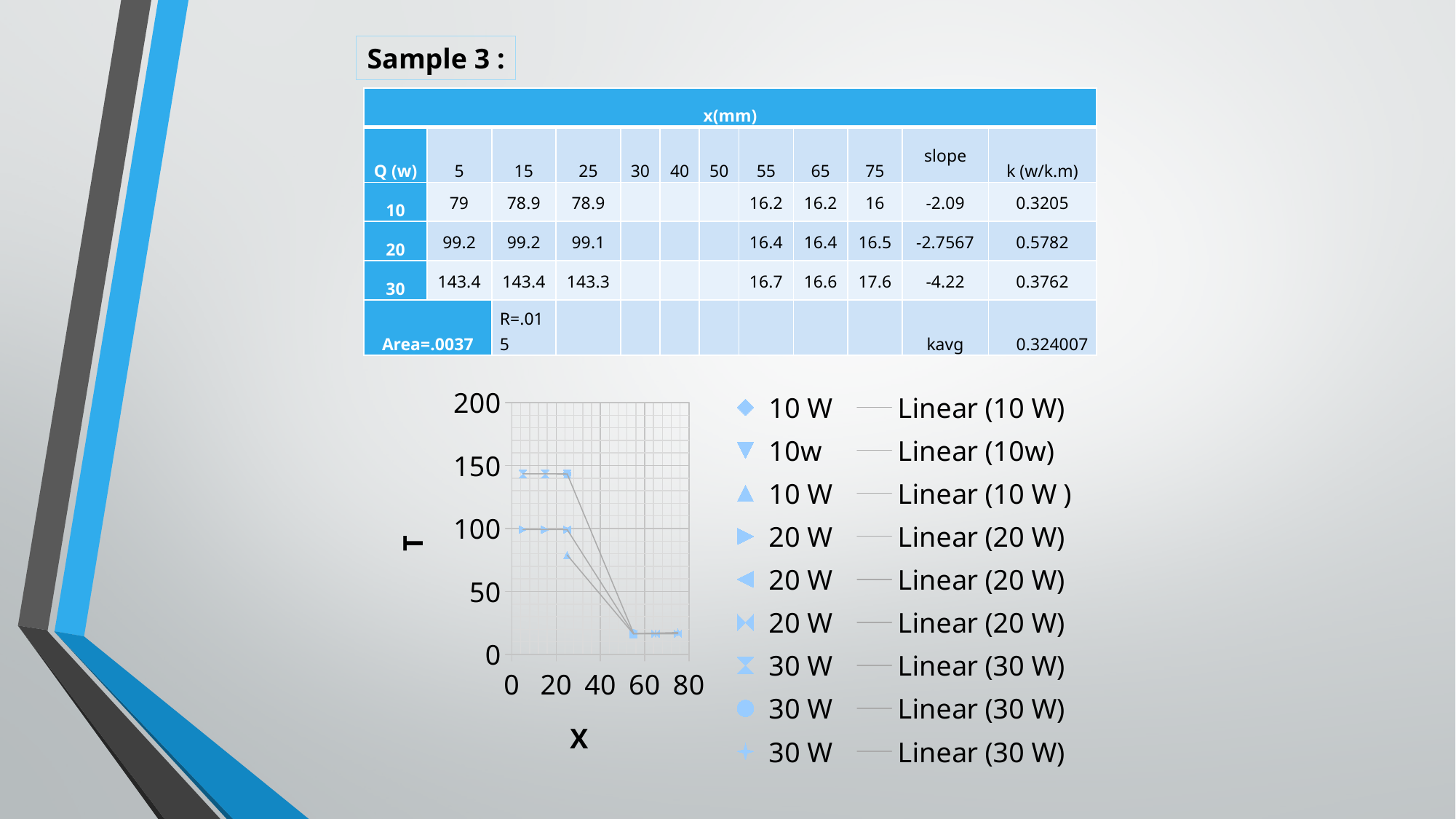
What is the highest tick value shown on the horizontal axis of the chart? 80 Which is larger on the T axis: the plotted points near X = 5 or the plotted points near X = 75? the points near X = 5 Are the plotted points of the middle group near X = 15 greater or less than 150 on the T axis? less Are the highest plotted points near X = 5 greater or less than 100 on the T axis? greater What kind of chart is shown on the slide? scatter chart What is the highest tick value shown on the vertical axis of the chart? 200 What is the label on the vertical axis of the chart? T What is the label on the horizontal axis of the chart? X Do the plotted T values rise or fall as X increases? fall Are the plotted points at X = 55 and beyond greater or less than 50 on the T axis? less How many entries does the chart legend list? 18